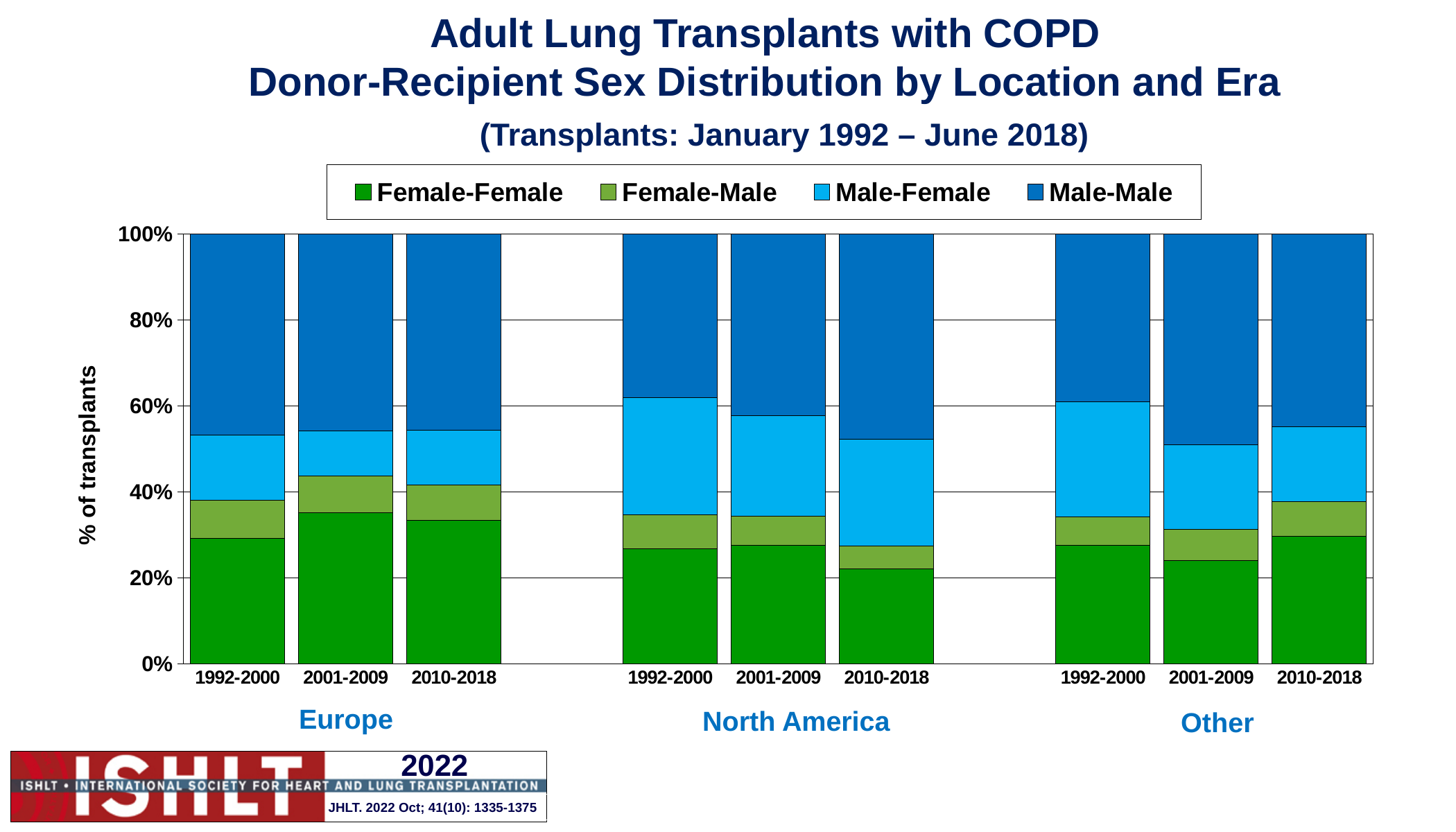
Within North America, does the Male-Male share rise or fall from 1992-2000 to 2010-2018? rise What is the label of the y axis? % of transplants Is the Female-Female share for Europe 2001-2009 greater or less than 40%? less How many bars are plotted in the chart? 9 Which three locations are shown along the x axis? Europe, North America, Other Is the Male-Male share for Other 2001-2009 greater or less than 40%? greater How many series does the legend list? 4 What kind of chart is shown on the slide? Stacked bar chart Is the Female-Female share for North America 2010-2018 greater or less than 20%? greater Which is larger, the Female-Female share for Europe 2001-2009 or for North America 2010-2018? Europe 2001-2009 Within Europe, which era has the smallest Female-Female share? 1992-2000 Within North America, which era has the smallest Female-Female share? 2010-2018